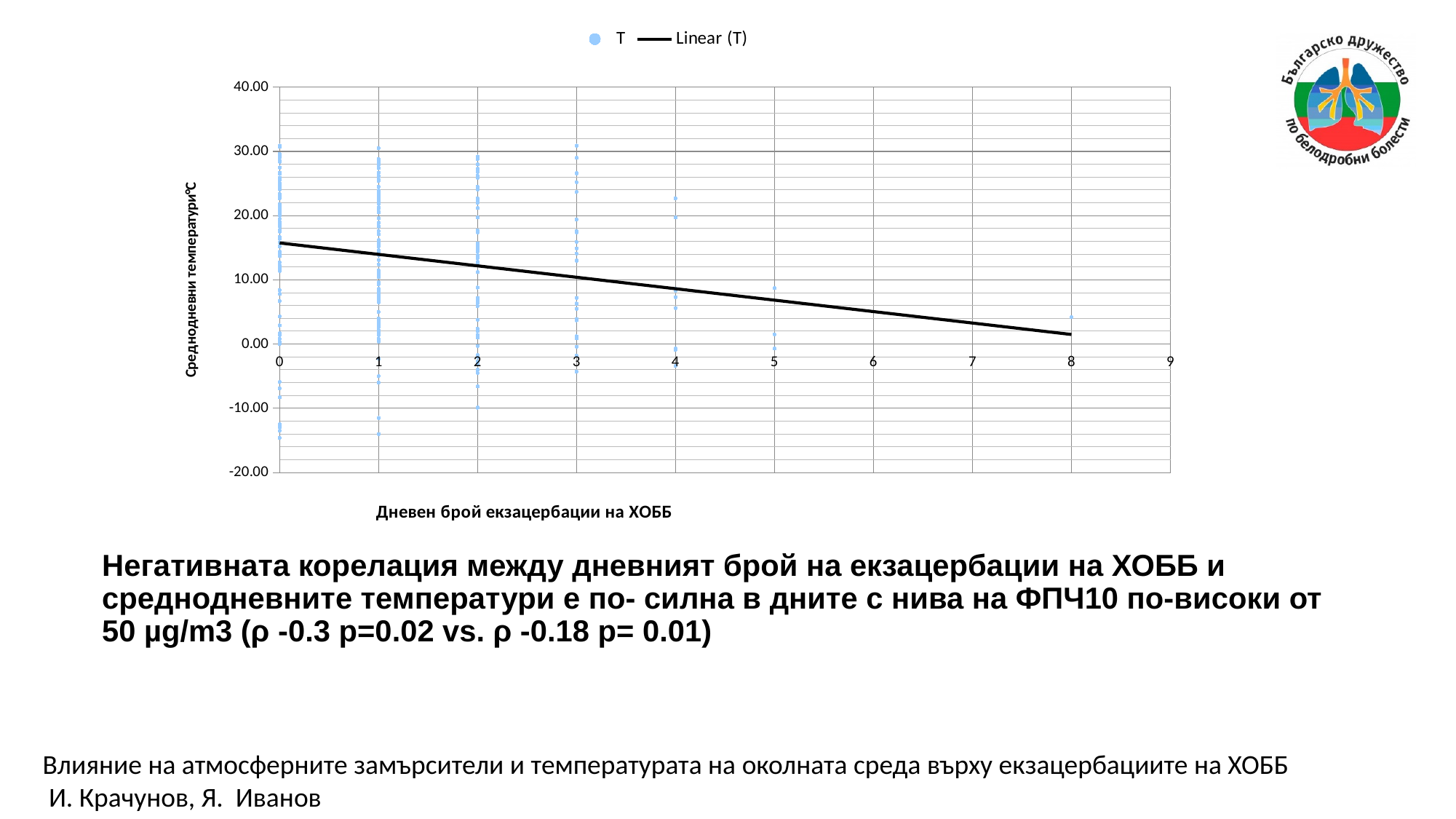
What are the two entries in the chart legend? T and Linear (T) What is the largest x-axis value at which data points are plotted? 8 Is the value of the trendline at x = 8 greater or less than 10.00? less Is the value of the trendline at x = 0 greater or less than 10.00? greater Is the value of the trendline at x = 4 greater or less than 20.00? less What is the title of the x axis of the chart? Дневен брой екзацербации на ХОББ How many entries does the chart legend list? 2 What kind of chart is shown on the slide? Scatter chart Does the linear trendline rise or fall as the daily number of exacerbations increases along the x axis? Falls What is the highest value shown on the y axis of the chart? 40.00 What is the highest tick value shown on the x axis? 9 What is the lowest value shown on the y axis of the chart? -20.00